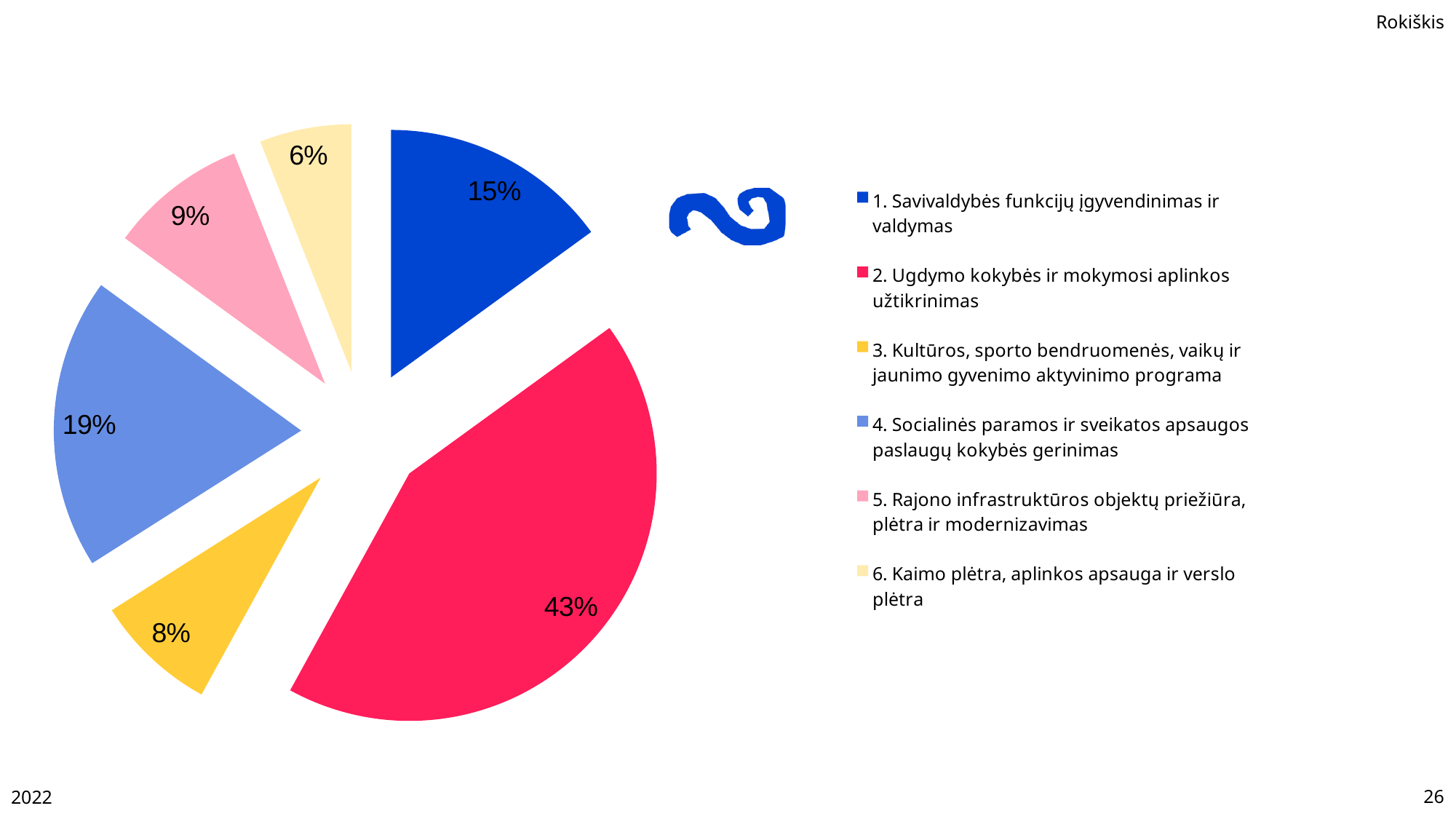
What share of the pie does "1. Savivaldybės funkcijų įgyvendinimas ir valdymas" have? 15% What share of the pie does "4. Socialinės paramos ir sveikatos apsaugos paslaugų kokybės gerinimas" have? 19% Which category has the largest slice of the pie? 2. Ugdymo kokybės ir mokymosi aplinkos užtikrinimas What colour is the slice for "5. Rajono infrastruktūros objektų priežiūra, plėtra ir modernizavimas"? pink What share of the pie does "3. Kultūros, sporto bendruomenės, vaikų ir jaunimo gyvenimo aktyvinimo programa" have? 8% What is the difference in percentage points between the slice for "4. Socialinės paramos ir sveikatos apsaugos paslaugų kokybės gerinimas" and the slice for "5. Rajono infrastruktūros objektų priežiūra, plėtra ir modernizavimas"? 10 What kind of chart is shown on the slide? pie chart Which is larger: the slice for "1. Savivaldybės funkcijų įgyvendinimas ir valdymas" or the slice for "3. Kultūros, sporto bendruomenės, vaikų ir jaunimo gyvenimo aktyvinimo programa"? 1. Savivaldybės funkcijų įgyvendinimas ir valdymas Which category has the smallest slice of the pie? 6. Kaimo plėtra, aplinkos apsauga ir verslo plėtra How many slices does the pie chart have? 6